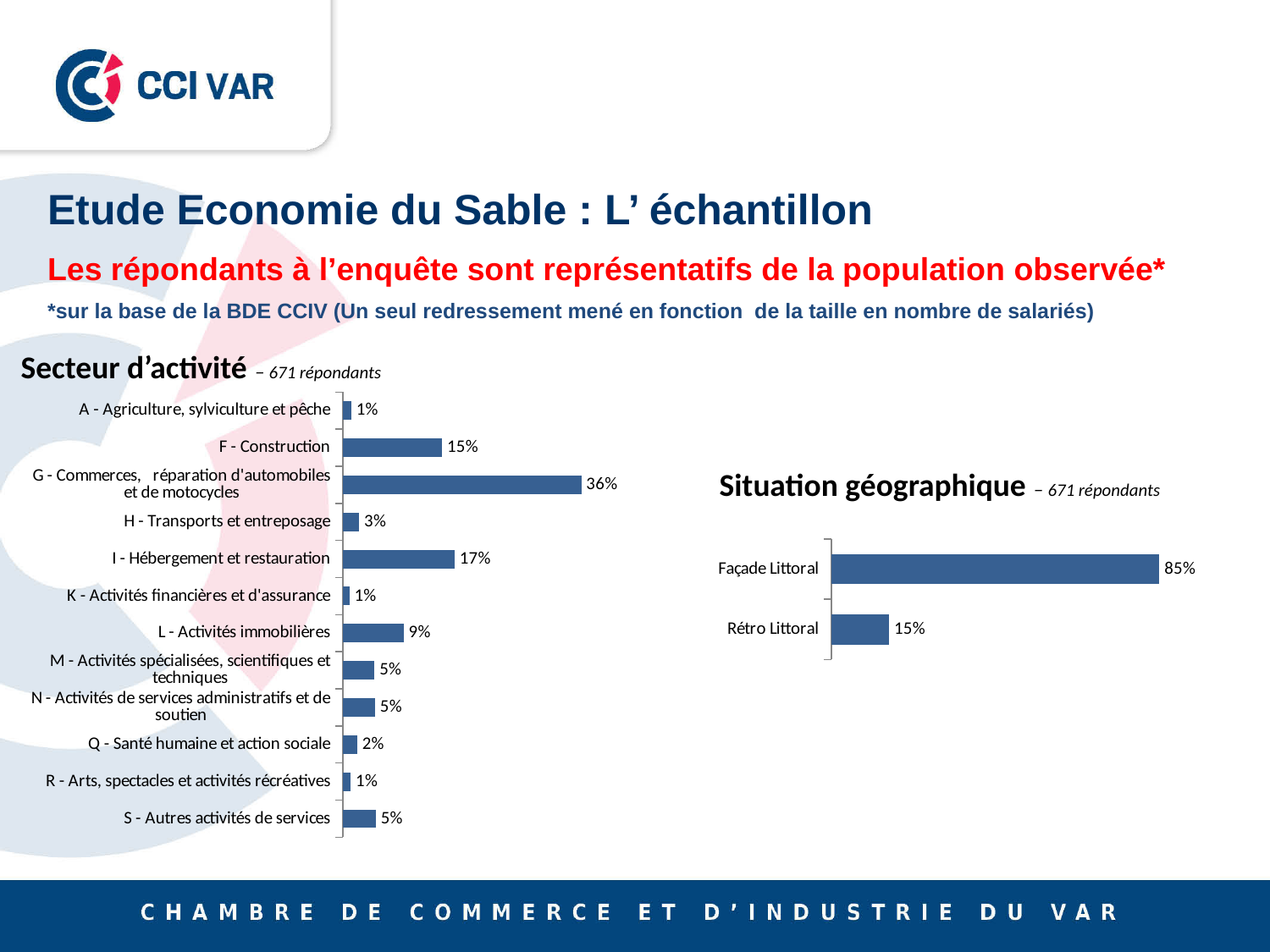
In the 'Situation géographique' chart, what is the value for 'Rétro Littoral'? 15% How many respondents does the 'Situation géographique' chart subtitle mention? 671 répondants In the 'Secteur d'activité' chart, what is the value for 'I - Hébergement et restauration'? 17% In the 'Secteur d'activité' chart, which category has the highest value? G - Commerces, réparation d'automobiles et de motocycles In the 'Situation géographique' chart, what is the value for 'Façade Littoral'? 85% In the 'Secteur d'activité' chart, what is the value for 'G - Commerces, réparation d'automobiles et de motocycles'? 36% In the 'Secteur d'activité' chart, which is larger: 'F - Construction' or 'I - Hébergement et restauration'? I - Hébergement et restauration How many categories are shown in the 'Situation géographique' chart? 2 In the 'Situation géographique' chart, what is the difference between 'Façade Littoral' and 'Rétro Littoral'? 70% How many categories are shown in the 'Secteur d'activité' chart? 12 What kind of chart is the 'Secteur d'activité' chart? Bar chart In the 'Secteur d'activité' chart, what is the difference between 'F - Construction' and 'L - Activités immobilières'? 6%